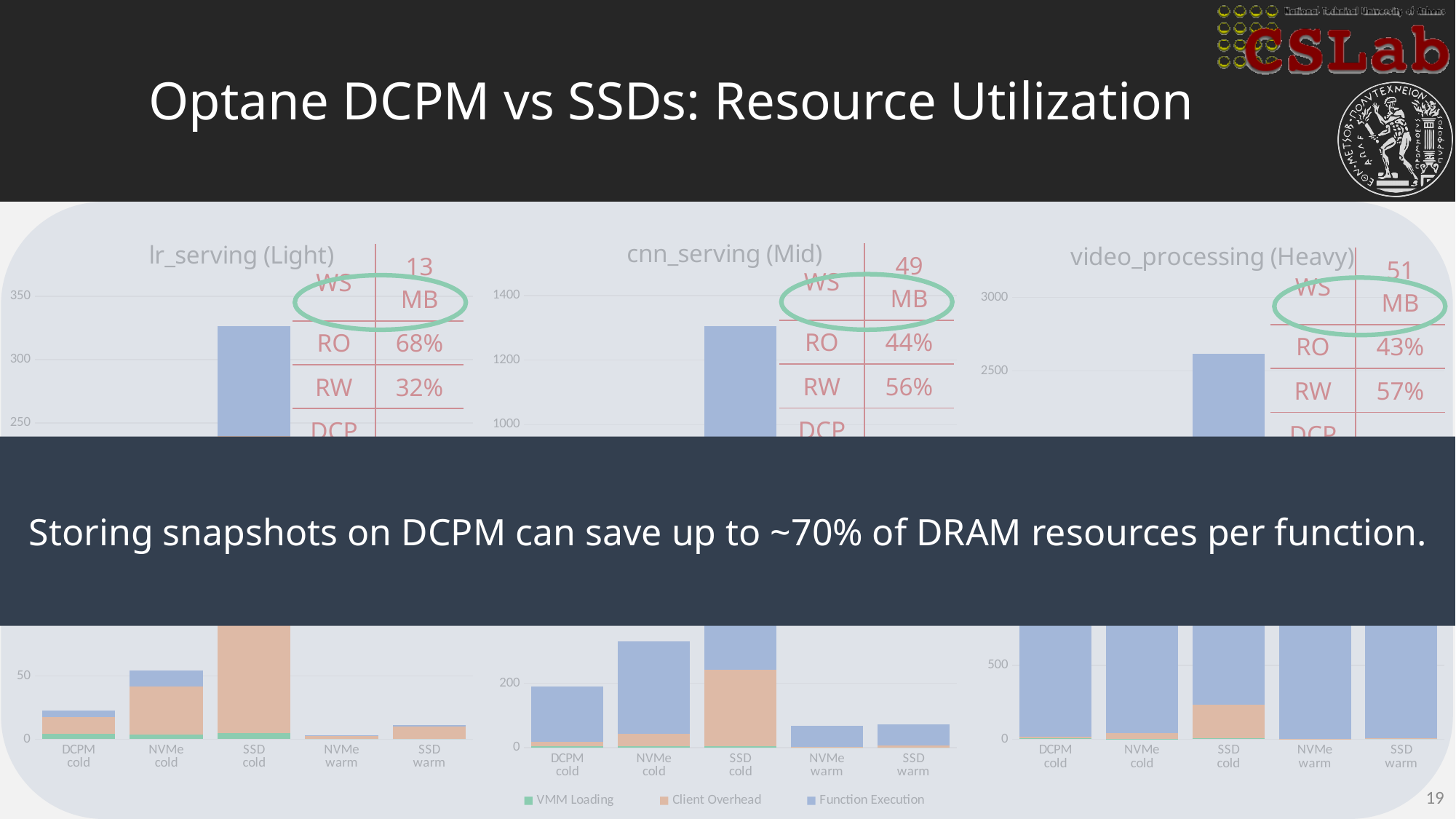
Which series is shown in blue in the legend? Function Execution In the cnn_serving (Mid) chart, is the total for NVMe warm greater or less than 200? less In the lr_serving (Light) chart, which category has the lowest total bar? NVMe warm In the cnn_serving (Mid) chart, which is larger, the total for NVMe cold or NVMe warm? NVMe cold In the lr_serving (Light) chart, which is larger, the total for NVMe warm or SSD warm? SSD warm How many series does the legend list for the charts on the slide? 3 In the lr_serving (Light) chart, is the total for DCPM cold greater or less than 50? less What is the WS value shown in the annotation table next to the lr_serving (Light) chart? 13 MB What kind of chart is the lr_serving (Light) chart? Stacked bar chart In the video_processing (Heavy) chart, is the total for SSD cold greater or less than 500? greater How many categories are shown on the x axis of the cnn_serving (Mid) chart? 5